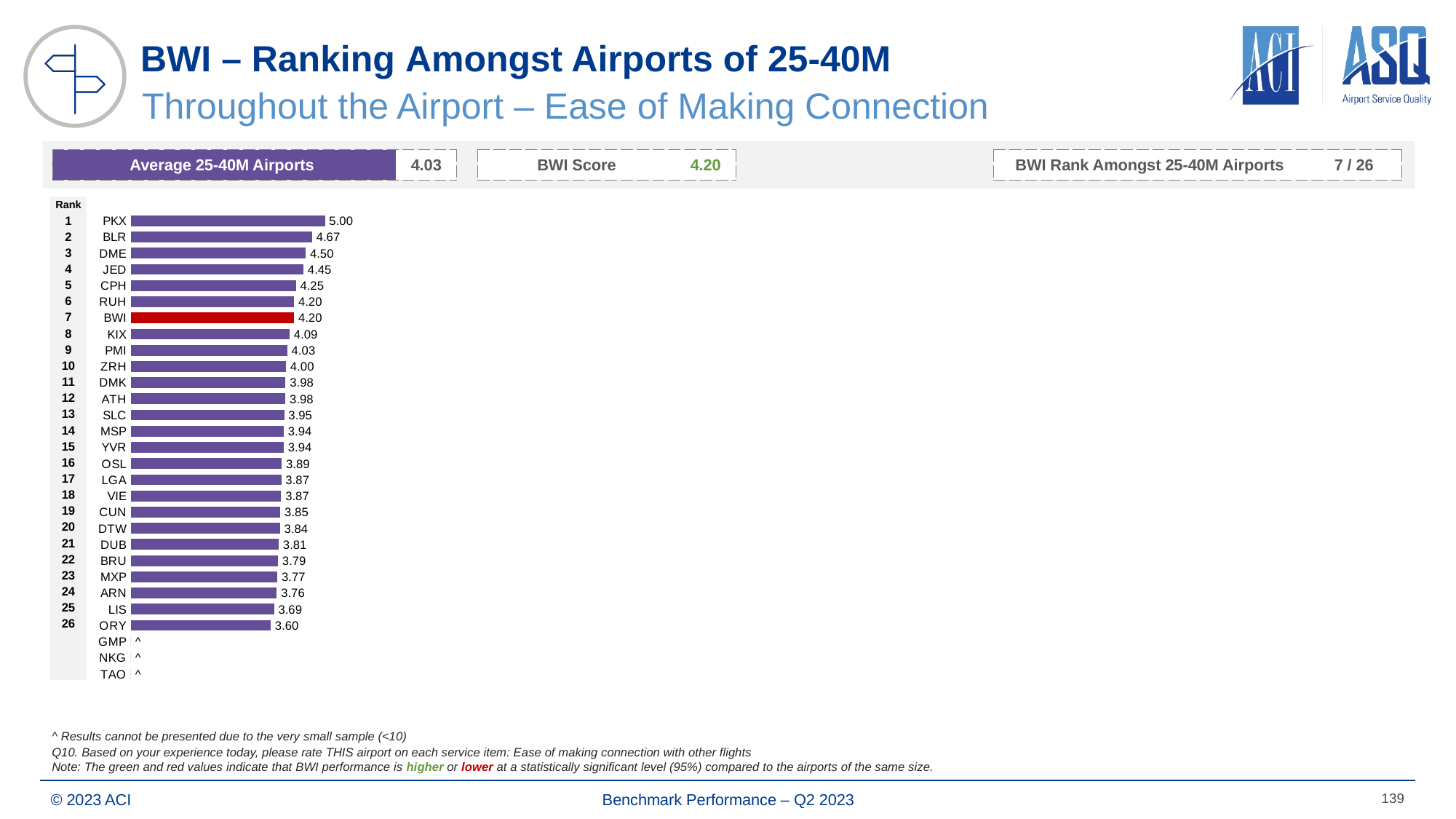
How many airports have a bar plotted in the chart? 26 What is the value for PKX in the chart? 5.00 What is the difference between the values for BLR and DME? 0.17 Which airport has the lowest plotted value in the chart? ORY What is the value for BWI in the chart? 4.20 Which has a larger value, LIS or ZRH? ZRH What is the value for ORY in the chart? 3.60 Which airport has the highest value in the chart? PKX Which has a larger value, CPH or KIX? CPH Which airport's bar is highlighted in red in the chart? BWI What is the difference between the values for PKX and BWI? 0.80 What kind of chart is shown on the slide? Bar chart